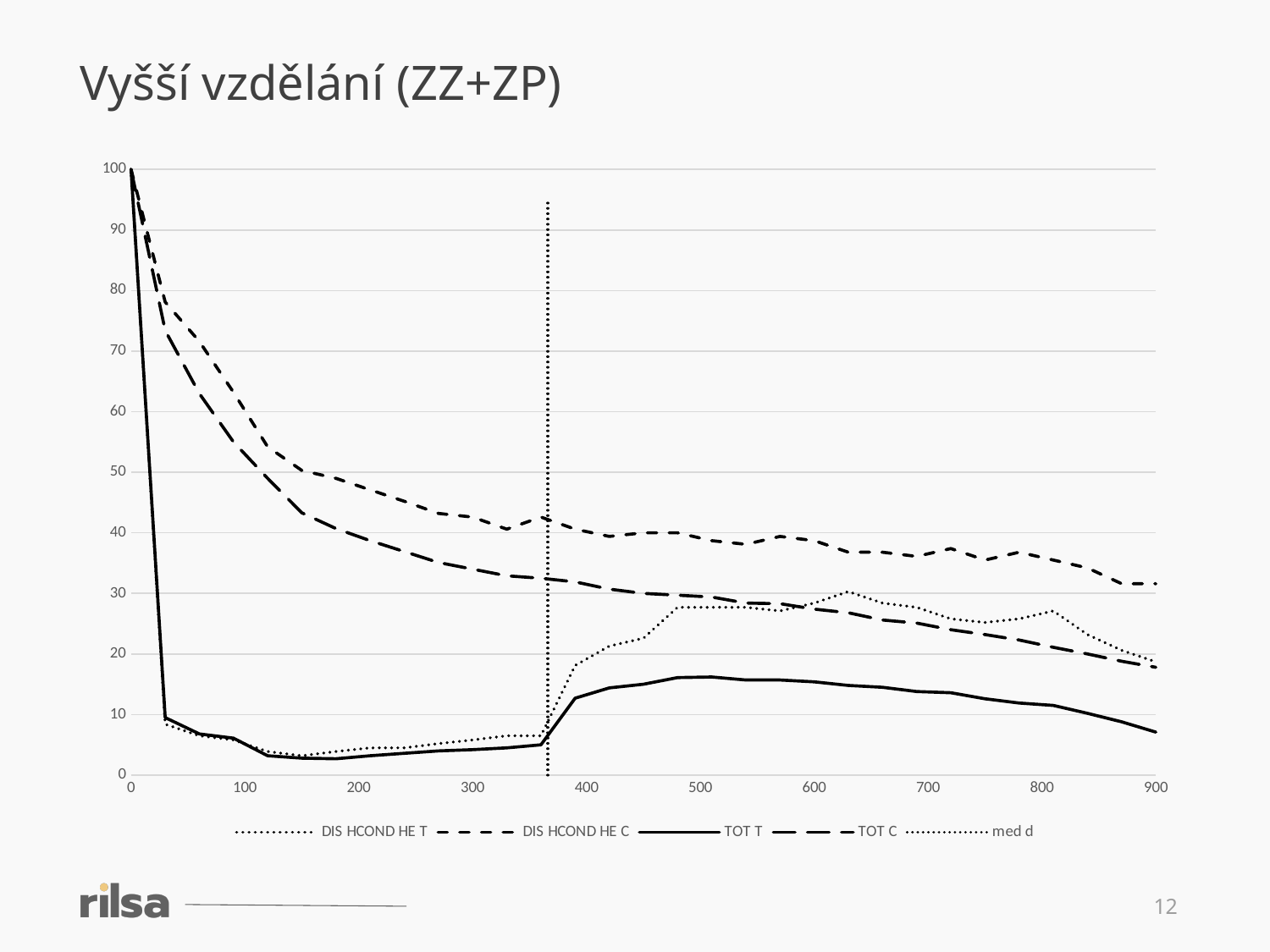
What is the title of the slide containing the chart? Vyšší vzdělání (ZZ+ZP) How many series does the legend list? 5 What value do the series start at when x = 0? 100 At x = 900, which is higher: DIS HCOND HE C or TOT C? DIS HCOND HE C Which series has the lowest value at x = 900? TOT T Is the value of DIS HCOND HE C at x = 100 greater or less than 50? greater At x = 500, which is higher: DIS HCOND HE T or TOT T? DIS HCOND HE T Is the value of TOT T at x = 900 greater or less than 10? less Is the value of TOT C at x = 300 greater or less than 40? less What kind of chart is shown on the slide? line chart Does the TOT C series rise or fall as x increases from 0 to 900? fall